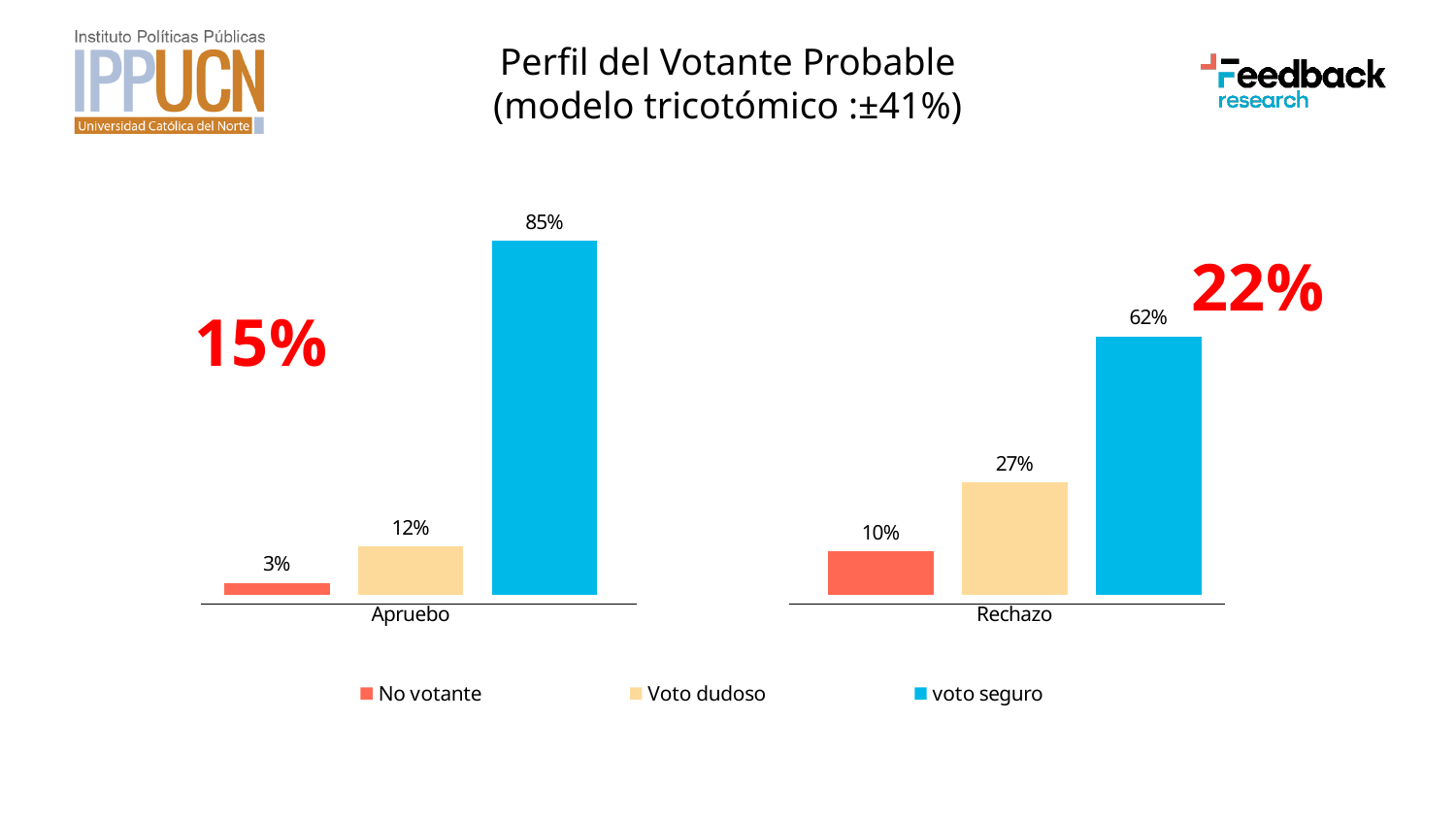
What is the value for "Voto dudoso" in the Apruebo category? 12% Which series has the highest value in the Rechazo category? voto seguro Which series has the lowest value in the Apruebo category? No votante What is the value for "No votante" in the Rechazo category? 10% What is the difference between the "voto seguro" values for Apruebo and Rechazo? 23% What is the value for "Voto dudoso" in the Rechazo category? 27% Which is larger: "Voto dudoso" for Apruebo or "Voto dudoso" for Rechazo? Rechazo How many categories are shown on the x axis? 2 How many series does the legend list? 3 What is the title of the chart? Perfil del Votante Probable (modelo tricotómico :±41%) What kind of chart is shown on the slide? Bar chart What is the value for "voto seguro" in the Apruebo category? 85%